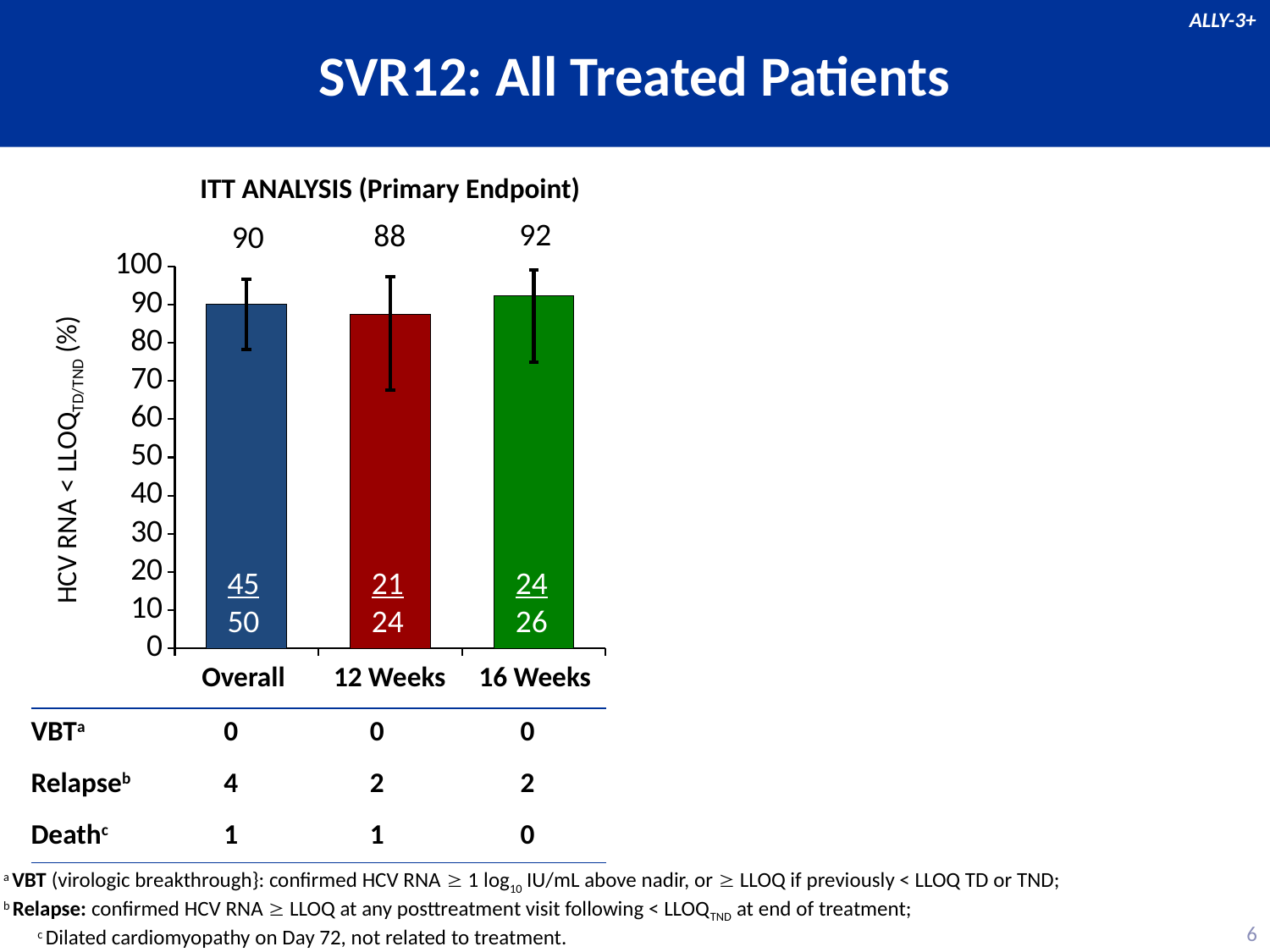
What is the difference between the SVR12 values for 16 Weeks and 12 Weeks? 4 Which is larger, the SVR12 value for Overall or for 12 Weeks? Overall What is the SVR12 value shown for the Overall group? 90 Which group has the lowest SVR12 value? 12 Weeks What fraction of patients is printed inside the Overall bar? 45/50 How many groups (bars) are shown in the chart? 3 What is the SVR12 value shown for the 16 Weeks group? 92 What fraction of patients is printed inside the 16 Weeks bar? 24/26 What is the title printed above the chart? ITT ANALYSIS (Primary Endpoint) What is the SVR12 value shown for the 12 Weeks group? 88 Which group has the highest SVR12 value? 16 Weeks What kind of chart is shown on the slide? Bar chart